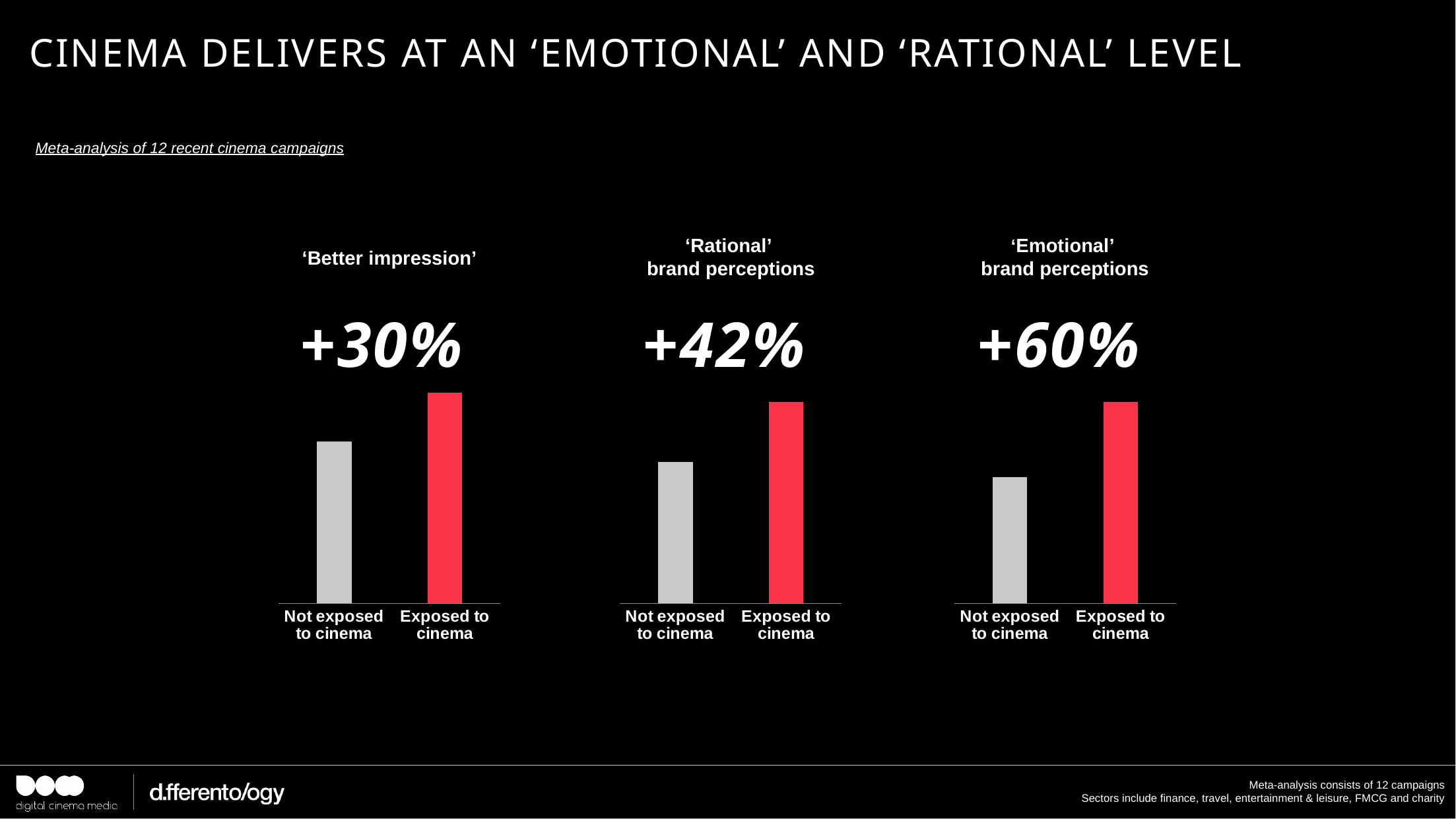
What uplift figure is printed above the 'Rational' brand perceptions chart? +42% What uplift figure is printed above the 'Better impression' chart? +30% In the 'Rational' brand perceptions chart, what colour is the 'Exposed to cinema' bar? red In the 'Better impression' chart, which bar is taller, 'Not exposed to cinema' or 'Exposed to cinema'? Exposed to cinema Which of the three charts shows the largest printed uplift? 'Emotional' brand perceptions In the 'Rational' brand perceptions chart, which bar is taller, 'Not exposed to cinema' or 'Exposed to cinema'? Exposed to cinema What kind of chart is used under the 'Better impression' heading? bar chart How many bar charts are shown on the slide? 3 Which of the three charts shows the smallest printed uplift? 'Better impression' In the 'Better impression' chart, how many bars are plotted? 2 In the 'Emotional' brand perceptions chart, which bar is shorter, 'Not exposed to cinema' or 'Exposed to cinema'? Not exposed to cinema What uplift figure is printed above the 'Emotional' brand perceptions chart? +60%